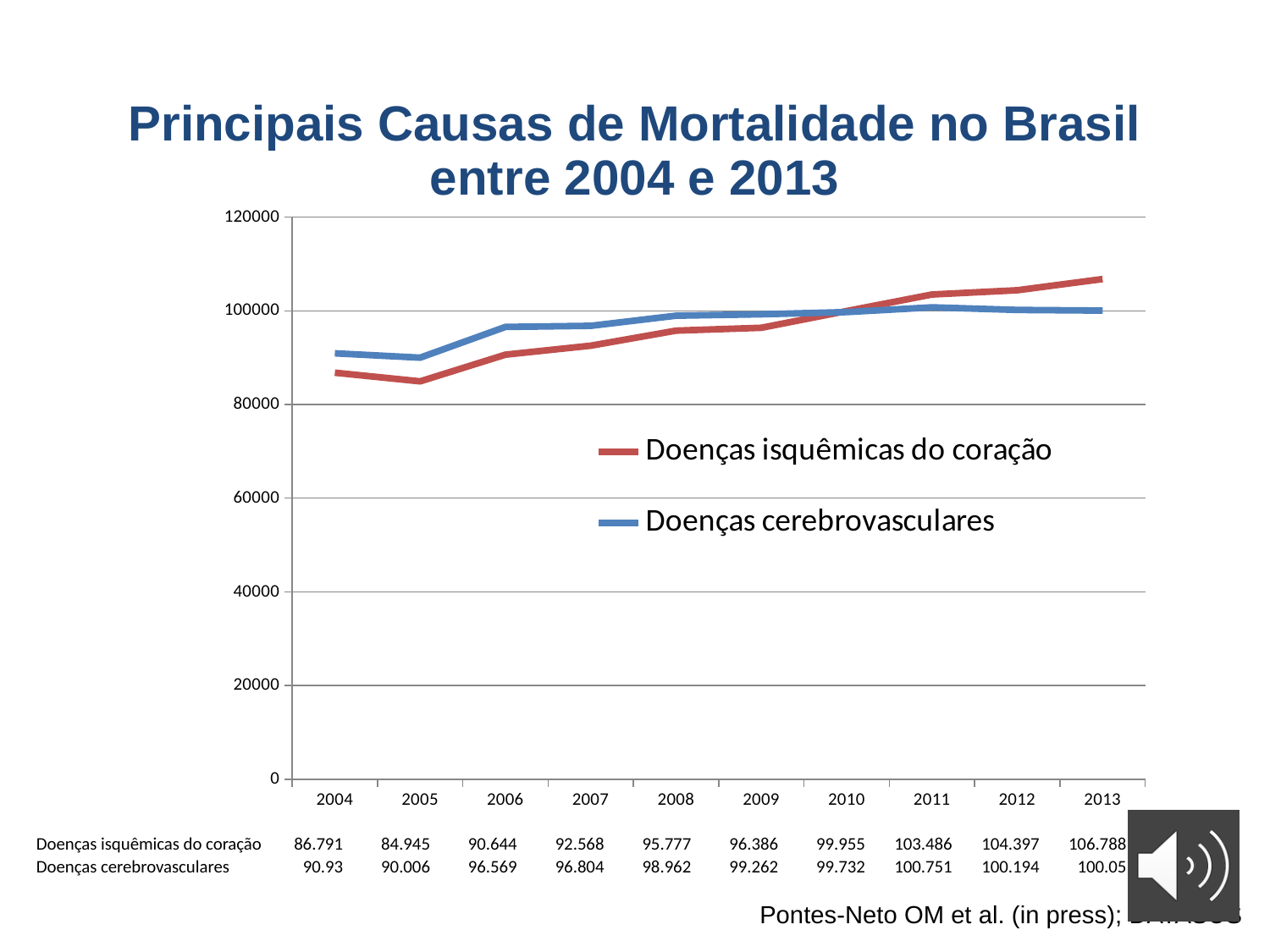
Which series has the higher value in 2013, Doenças isquêmicas do coração or Doenças cerebrovasculares? Doenças isquêmicas do coração How many series does the legend list? 2 How many years are plotted along the x axis? 10 Which series has the higher value in 2004, Doenças isquêmicas do coração or Doenças cerebrovasculares? Doenças cerebrovasculares What is the value for Doenças cerebrovasculares in 2011? 100.751 What is the value for Doenças isquêmicas do coração in 2013? 106.788 What is the value for Doenças isquêmicas do coração in 2004? 86.791 What kind of chart is shown on the slide? line chart In which year is Doenças isquêmicas do coração at its lowest? 2005 In which year is Doenças isquêmicas do coração at its highest? 2013 Does the Doenças isquêmicas do coração line generally rise or fall from 2004 to 2013? rise By how much did Doenças isquêmicas do coração increase from 2004 to 2013? 19.997